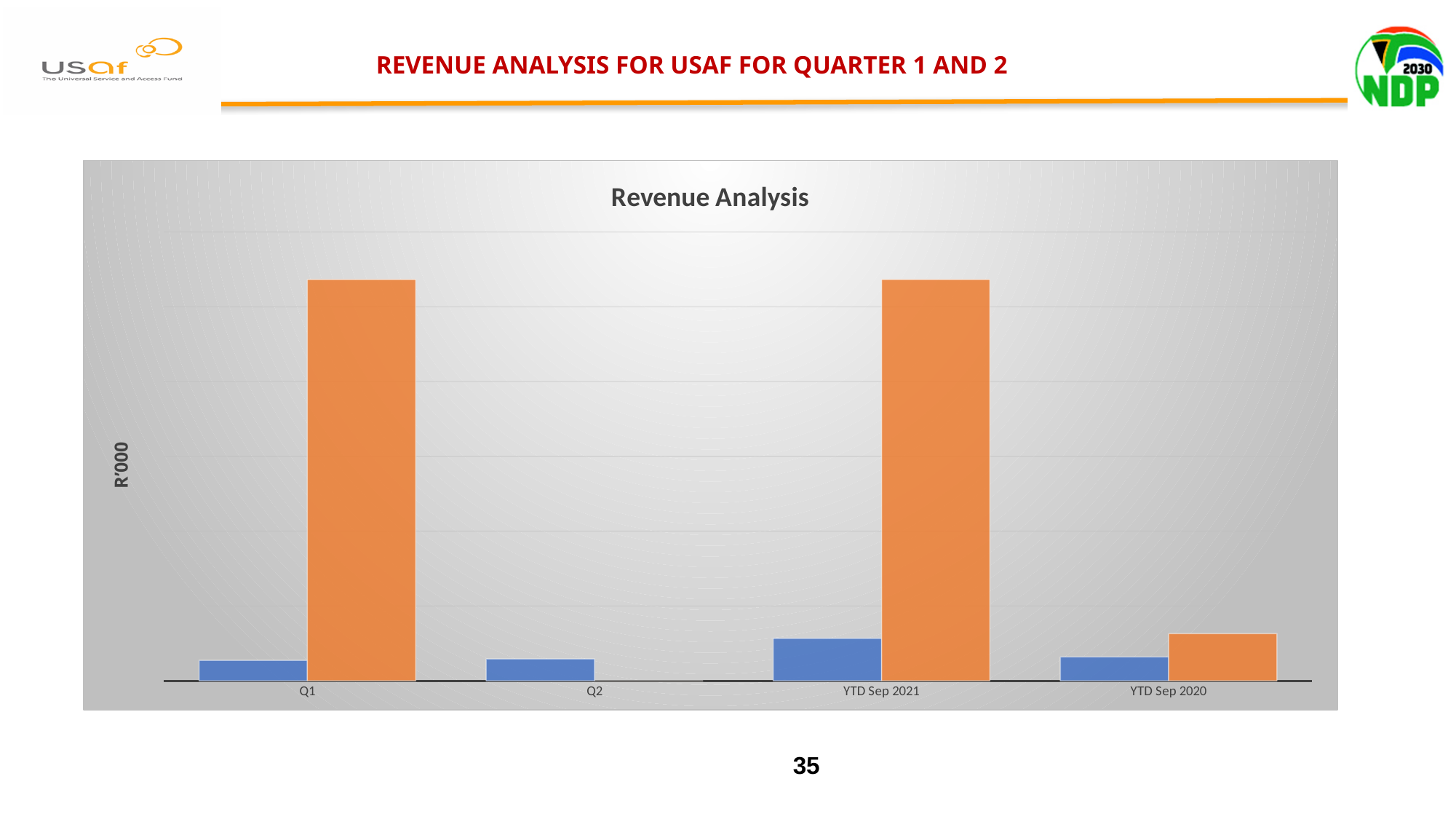
How many categories are shown on the x axis of the Revenue Analysis chart? 4 What kind of chart is shown on the slide? bar chart What is the label on the vertical axis of the chart? R'000 What is the title of the chart? Revenue Analysis Is the blue bar for YTD Sep 2021 taller or shorter than the blue bar for Q2? taller Is the orange bar for YTD Sep 2020 taller or shorter than the orange bar for YTD Sep 2021? shorter In the Q1 category, which bar is taller, the blue bar or the orange bar? the orange bar Which category has the tallest blue bar? YTD Sep 2021 Which category is listed last on the x axis? YTD Sep 2020 Which category has the smallest orange bar? Q2